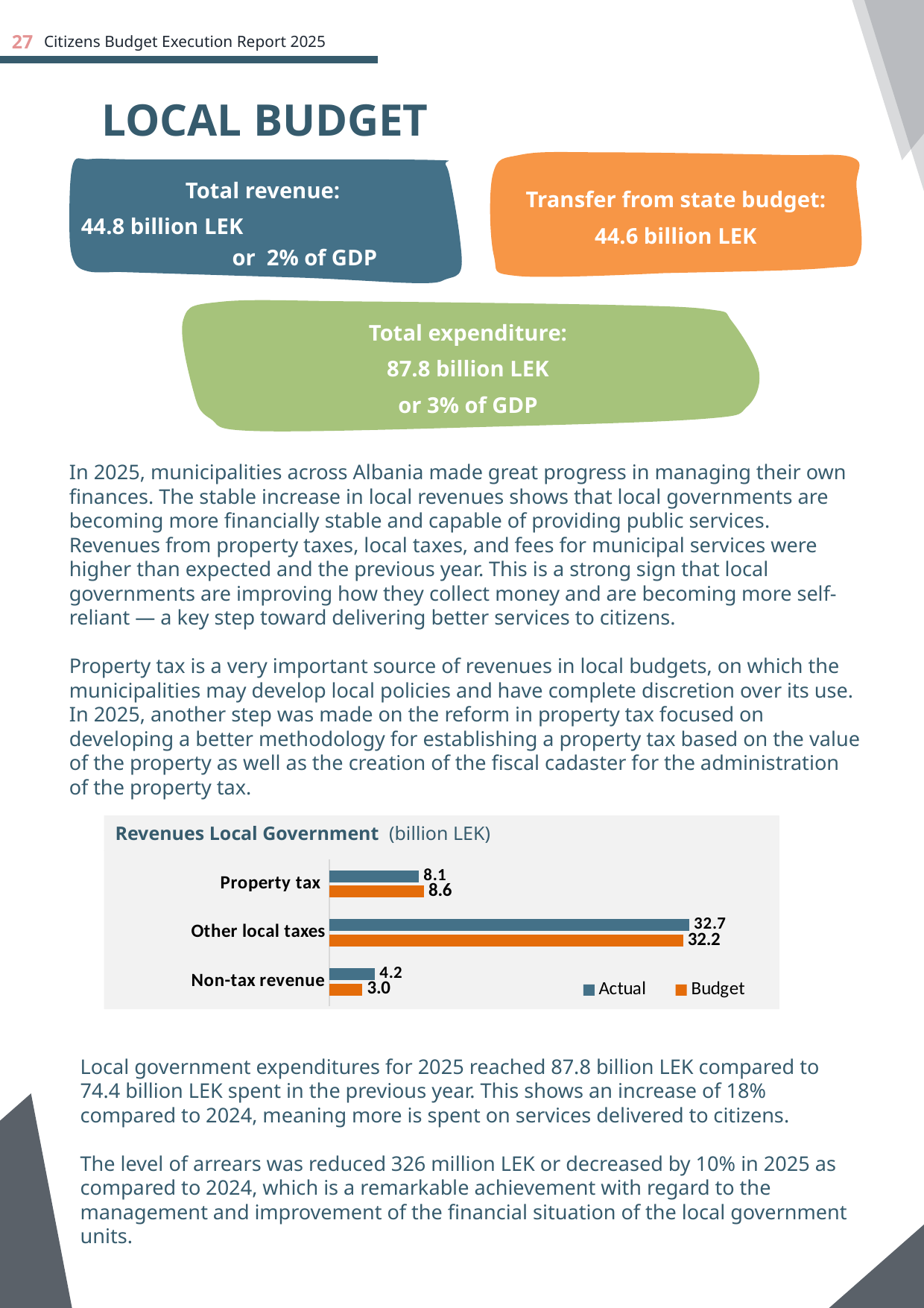
What is the difference between the Budget and Actual values for Property tax in the Revenues Local Government chart? 0.5 What is the Budget value for Property tax in the Revenues Local Government chart? 8.6 How many series does the legend of the Revenues Local Government chart list? 2 What is the Actual value for Non-tax revenue in the Revenues Local Government chart? 4.2 What is the difference between the Actual and Budget values for Non-tax revenue in the Revenues Local Government chart? 1.2 What is the Actual value for Other local taxes in the Revenues Local Government chart? 32.7 Which category has the highest Actual value in the Revenues Local Government chart? Other local taxes Which category has the lowest Budget value in the Revenues Local Government chart? Non-tax revenue How many categories are shown in the Revenues Local Government chart? 3 For Property tax in the Revenues Local Government chart, which is larger, the Actual or the Budget value? Budget What type of chart is the Revenues Local Government chart? Bar chart What is the Budget value for Non-tax revenue in the Revenues Local Government chart? 3.0